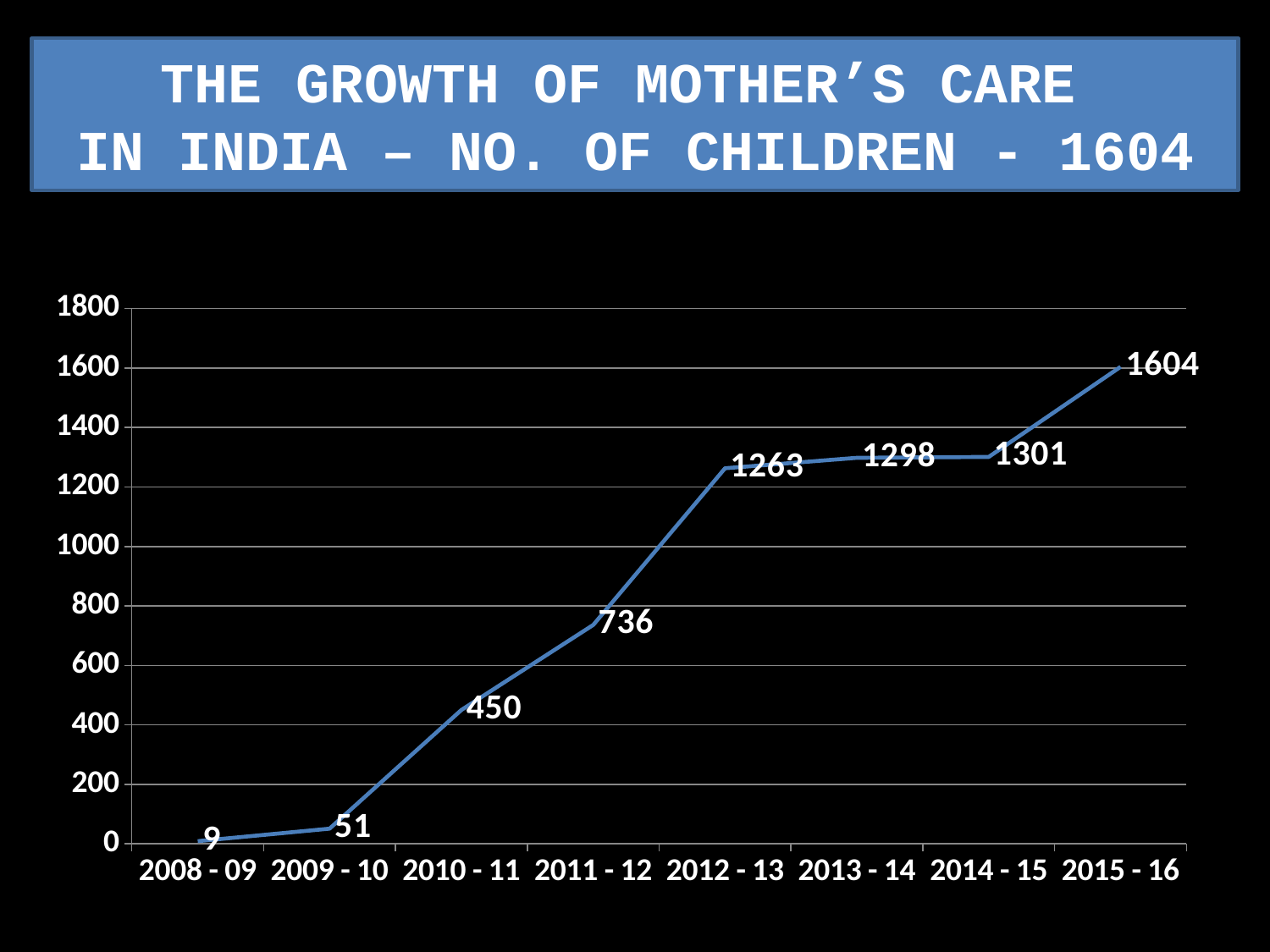
What kind of chart is shown on the slide? line chart How many years are plotted on the x axis? 8 What is the number of children for 2012 - 13? 1263 Is the value for 2011 - 12 greater or less than 800? less What is the number of children for 2010 - 11? 450 Which year has the lowest number of children? 2008 - 09 What is the difference in the number of children between 2015 - 16 and 2014 - 15? 303 Which year has the highest number of children? 2015 - 16 Which is larger, the value for 2011 - 12 or the value for 2012 - 13? 2012 - 13 What is the difference in the number of children between 2011 - 12 and 2010 - 11? 286 Do the values rise or fall from 2008 - 09 to 2015 - 16? rise What is the number of children for 2008 - 09? 9